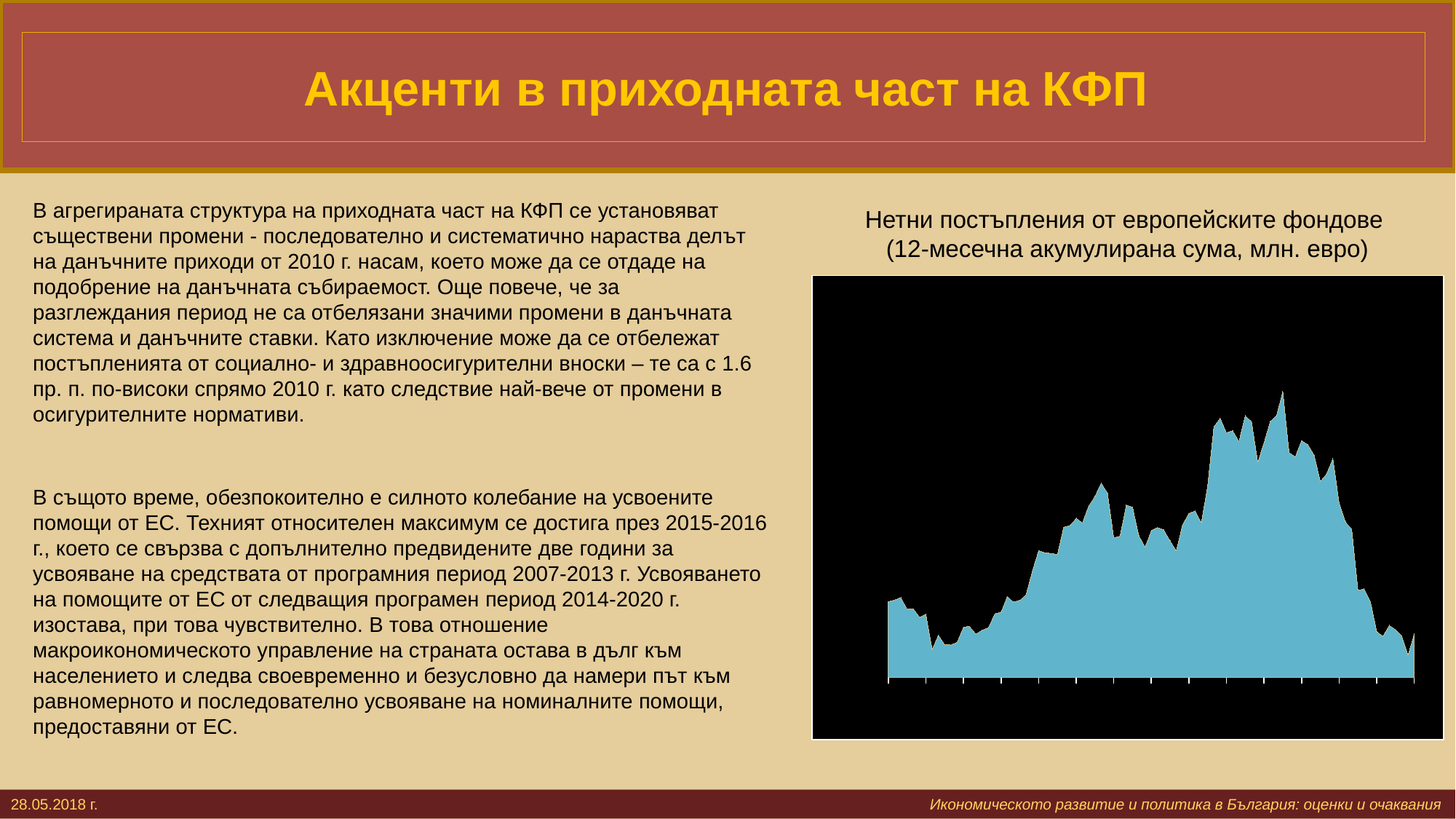
In what unit are the values of the chart expressed, according to its title? млн. евро After reaching its peak, does the series rise or fall towards the end of the period? fall What is the title of the chart on the slide? Нетни постъпления от европейските фондове (12-месечна акумулирана сума, млн. евро) Is the value at the end of the series higher or lower than the value at the start? lower What kind of chart is shown on the slide? area chart Does the plotted series reach its peak in the first half or the second half of the period shown? second half